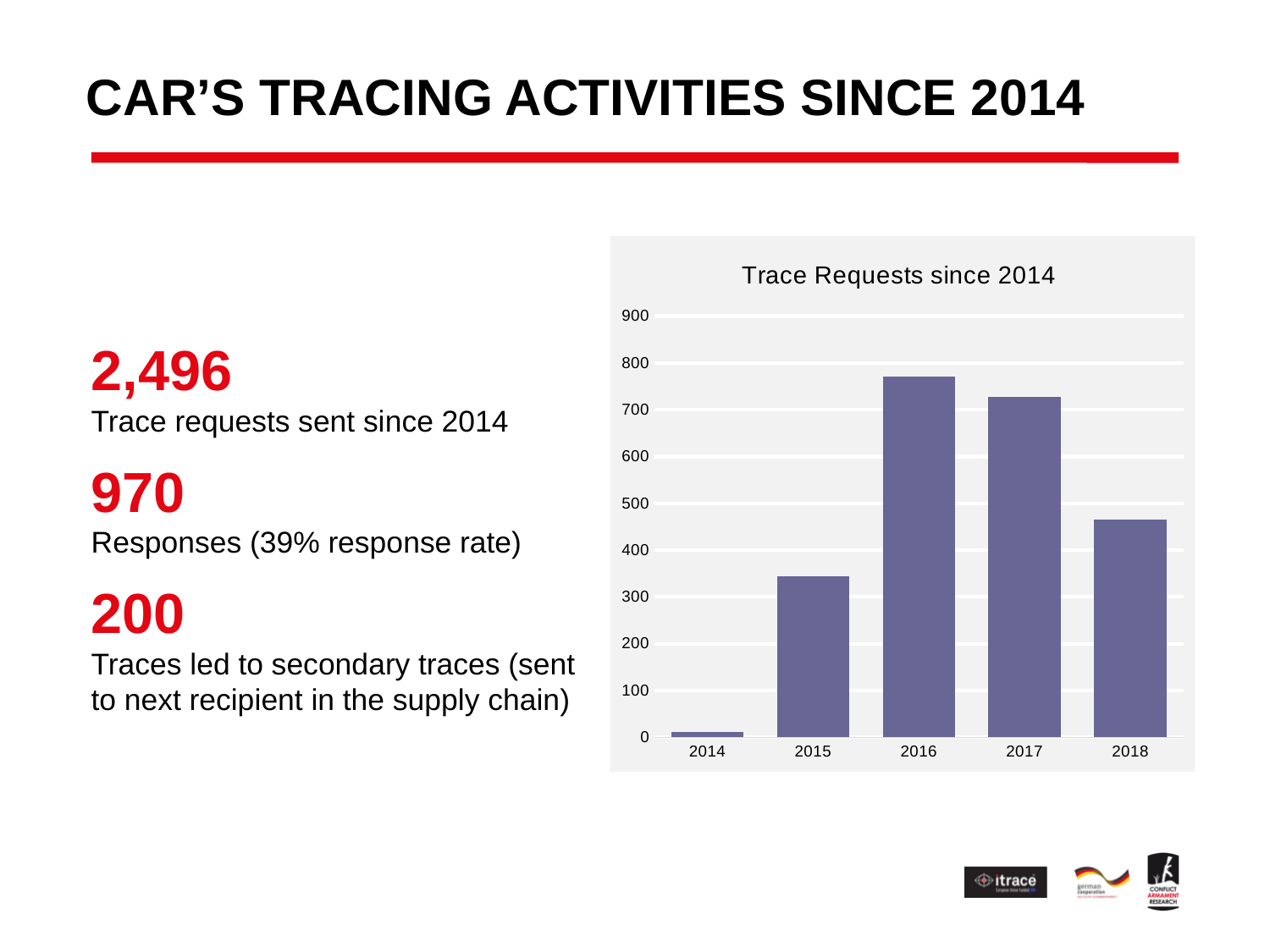
Is the value for 2014 greater or less than 100? less How many years are shown on the x axis of the chart? 5 Is the value for 2018 greater or less than 400? greater Do the trace requests rise or fall from 2016 to 2018? fall Which year has the highest number of trace requests? 2016 Which year has the lowest number of trace requests? 2014 What kind of chart is shown on the slide? bar chart Which year has more trace requests, 2016 or 2017? 2016 What is the title of the chart? Trace Requests since 2014 Is the value for 2015 greater or less than 400? less Which year has more trace requests, 2015 or 2018? 2018